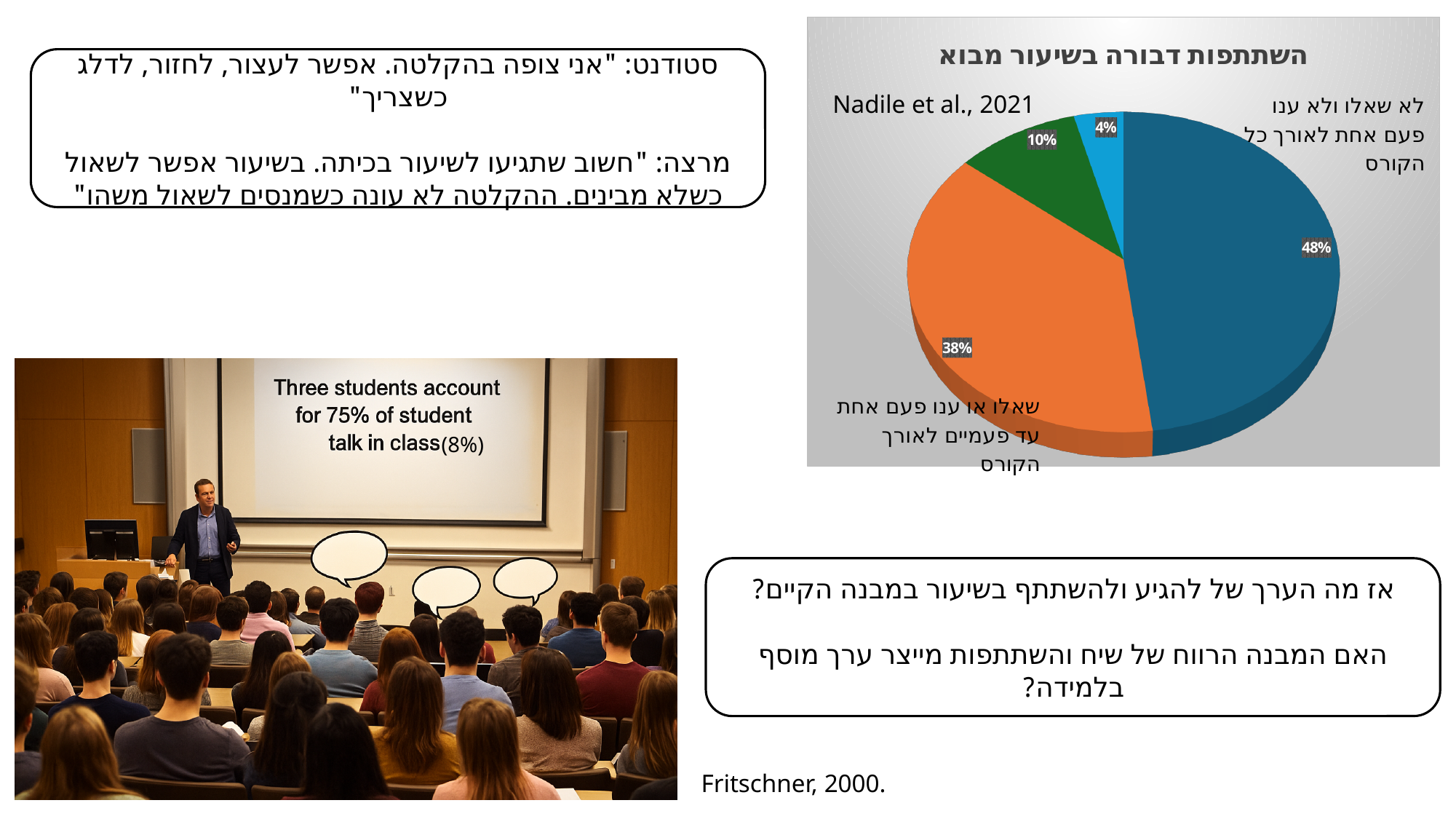
Which is larger: the slice for "לא שאלו ולא ענו פעם אחת לאורך כל הקורס" or the slice for "שאלו או ענו פעם אחת עד פעמיים לאורך הקורס"? לא שאלו ולא ענו פעם אחת לאורך כל הקורס What percentage of the pie is the slice labelled "שאלו או ענו פעם אחת עד פעמיים לאורך הקורס"? 38% By how many percentage points does the "לא שאלו ולא ענו" slice exceed the "שאלו או ענו פעם אחת עד פעמיים" slice? 10 percentage points Which slice of the pie chart is the largest? לא שאלו ולא ענו פעם אחת לאורך כל הקורס (48%) What percentage is shown on the green slice of the pie chart? 10% How many slices does the pie chart have? 4 What source citation is shown on the pie chart? Nadile et al., 2021 What kind of chart is shown on the slide? pie chart What is the title of the pie chart? השתתפות דבורה בשיעור מבוא What is the percentage of the smallest slice in the pie chart? 4% What percentage of the pie is the slice labelled "לא שאלו ולא ענו פעם אחת לאורך כל הקורס"? 48% What is the combined share of the two labelled slices (48% and 38%)? 86%